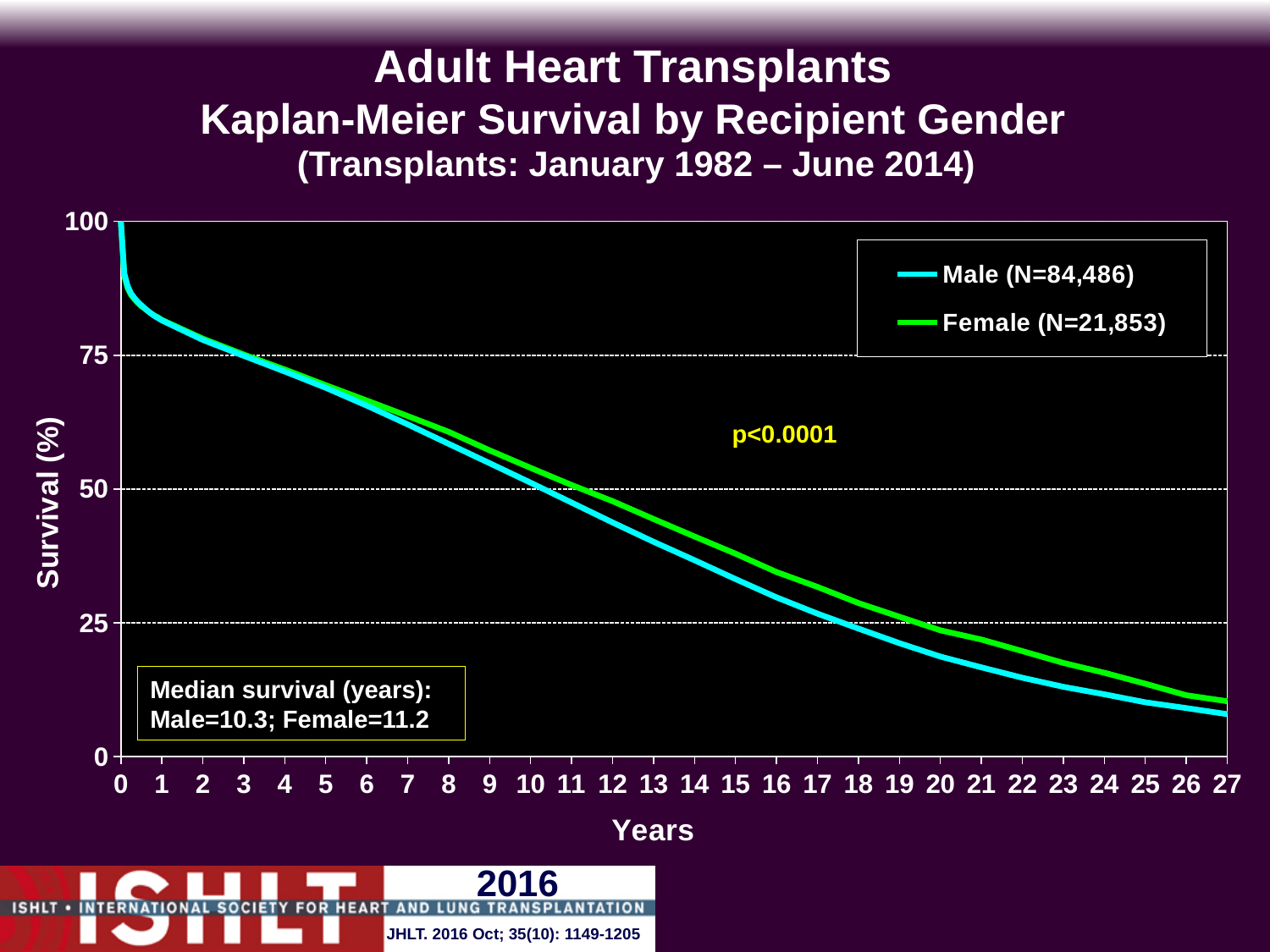
What is the median survival in years for female recipients? 11.2 Is the female survival value at 5 years greater or less than 50? greater What is the number of female recipients (N) shown in the legend? 21,853 At 15 years, which curve shows higher survival, Male or Female? Female What is the difference in median survival (years) between female and male recipients? 0.9 Which recipient gender has the longer median survival? Female What is the median survival in years for male recipients? 10.3 Do the survival curves rise or fall as years increase? fall How many series does the legend list? 2 Is the male survival value at 20 years greater or less than 25? less What kind of chart is shown on the slide? line chart What is the number of male recipients (N) shown in the legend? 84,486